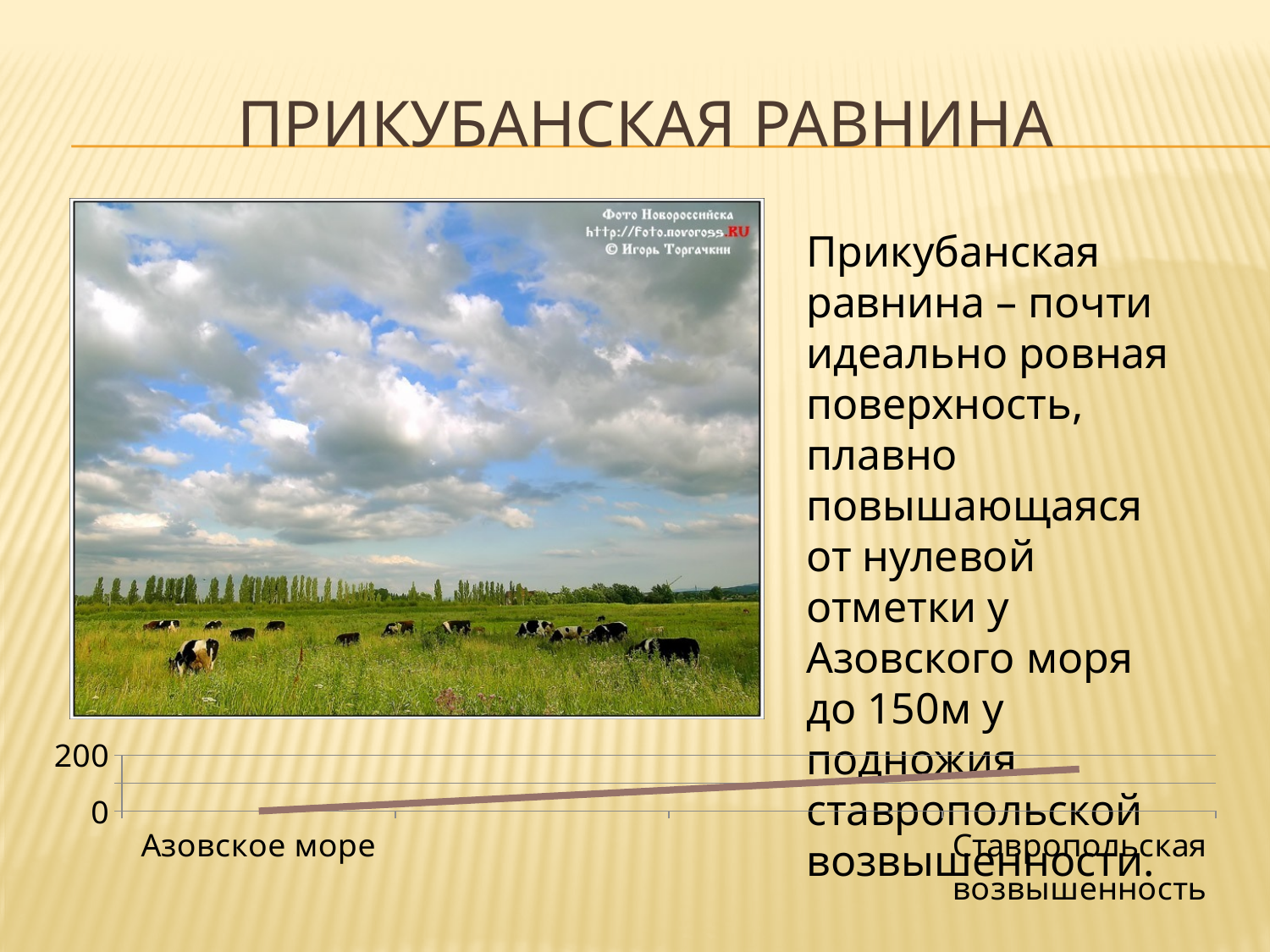
Is the value for Ставропольская возвышенность greater or less than 0? greater Which category has the highest value on the chart? Ставропольская возвышенность What is the value for Азовское море on the chart? 0 What is the label of the first category on the x axis of the chart? Азовское море What is the highest tick value shown on the y axis of the chart? 200 What kind of chart is shown at the bottom of the slide? line chart Is the value for Ставропольская возвышенность greater or less than 200? less Does the line rise or fall from Азовское море to Ставропольская возвышенность? rise Which category has the lowest value on the chart? Азовское море Which category has the higher value on the chart, Азовское море or Ставропольская возвышенность? Ставропольская возвышенность